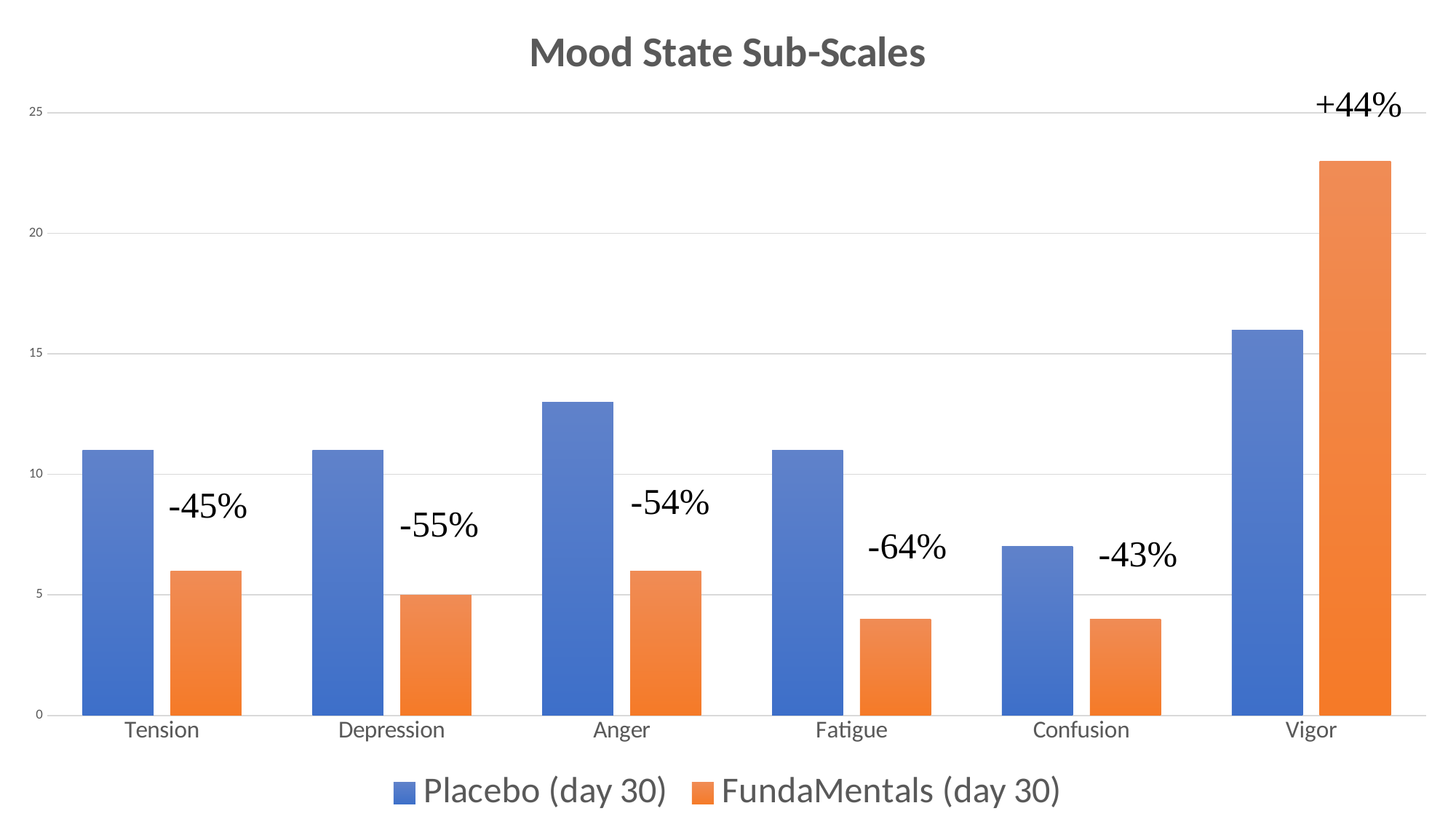
What kind of chart is shown on the slide? bar chart Is the Placebo (day 30) value for Confusion greater or less than 10? less What percentage change is printed above the Depression bars? -55% Is the FundaMentals (day 30) value for Vigor greater or less than 20? greater Which category has the highest FundaMentals (day 30) bar? Vigor What percentage change is printed above the Fatigue bars? -64% Which category has the lowest Placebo (day 30) bar? Confusion For Vigor, which series has the larger value, Placebo (day 30) or FundaMentals (day 30)? FundaMentals (day 30) How many series does the legend list? 2 What is the title of the chart? Mood State Sub-Scales How many mood sub-scale categories are shown on the x axis? 6 What percentage change is printed above the Vigor bars? +44%